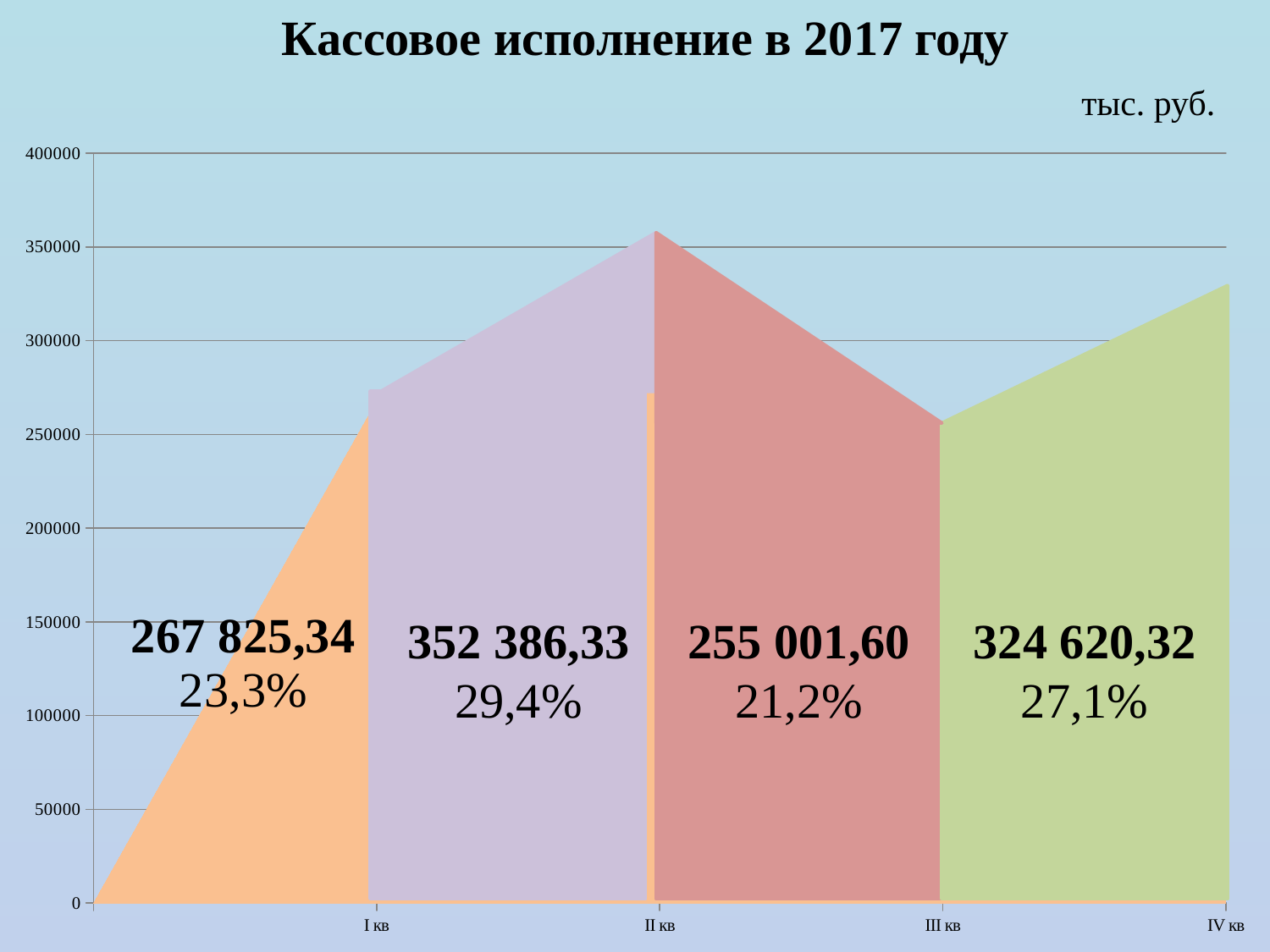
What is the value for I кв? 267 825,34 What is the value for III кв? 255 001,60 What is the title of the chart? Кассовое исполнение в 2017 году Which quarter has the lowest value? III кв Which is larger, the value for IV кв or the value for I кв? IV кв Which quarter has the highest value? II кв Is the value for III кв greater or less than 300000? less What is the value for II кв? 352 386,33 How many quarters are shown on the x axis? 4 What is the difference between the values for II кв and I кв? 84 560,99 What percentage share is shown for IV кв? 27,1% What kind of chart is this? area chart